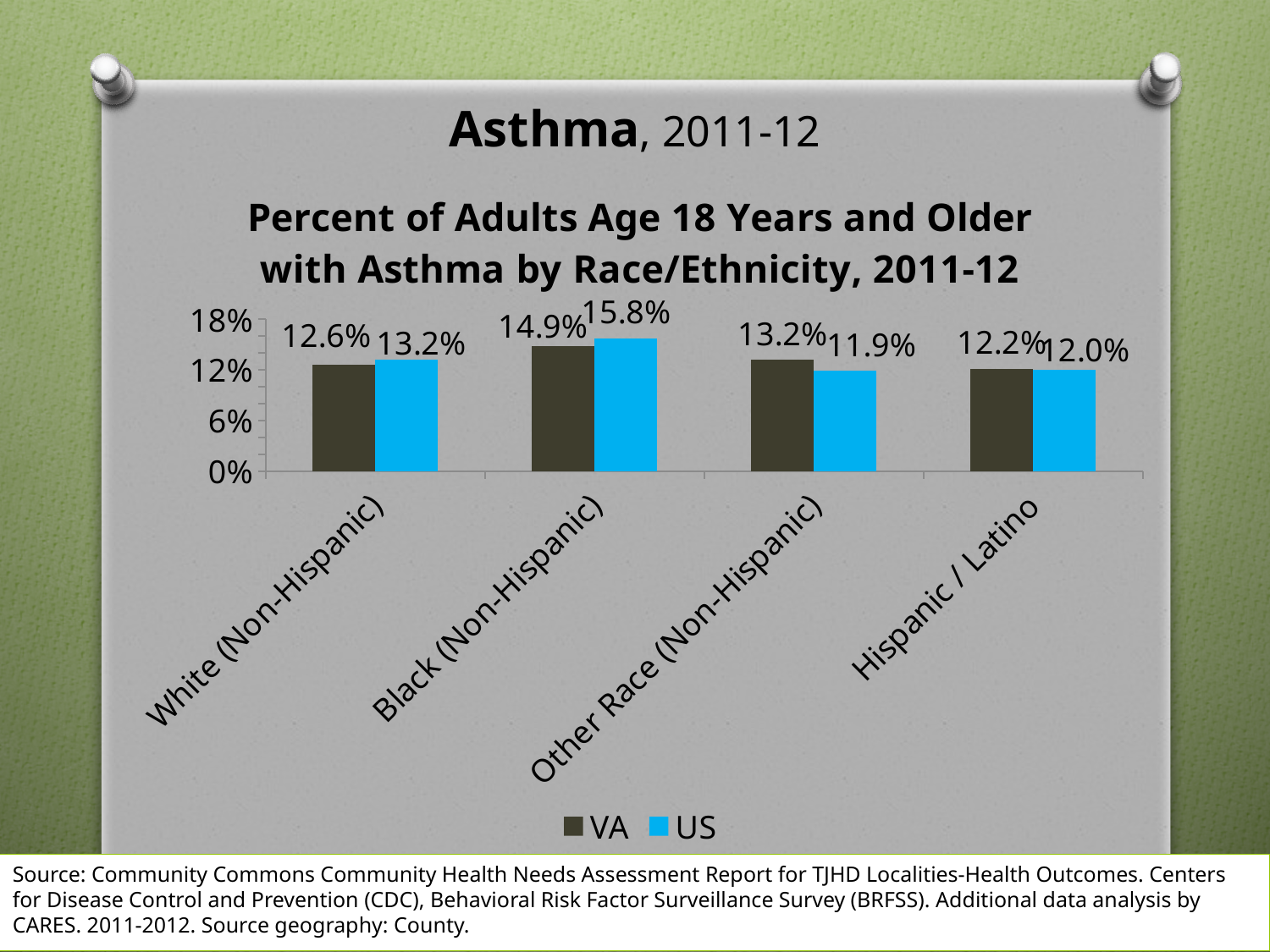
What is the difference between the US and VA values for Black (Non-Hispanic)? 0.9% How many series does the legend list? 2 Which race/ethnicity category has the highest VA value? Black (Non-Hispanic) What kind of chart is shown on the slide? Bar chart What is the US value for Other Race (Non-Hispanic)? 11.9% What is the US value for Black (Non-Hispanic)? 15.8% Which race/ethnicity category has the lowest US value? Other Race (Non-Hispanic) Which series is shown in light blue in the legend? US What is the VA value for White (Non-Hispanic)? 12.6% For Other Race (Non-Hispanic), which is larger, the VA value or the US value? VA How many race/ethnicity categories are shown on the x axis? 4 What is the VA value for Hispanic / Latino? 12.2%